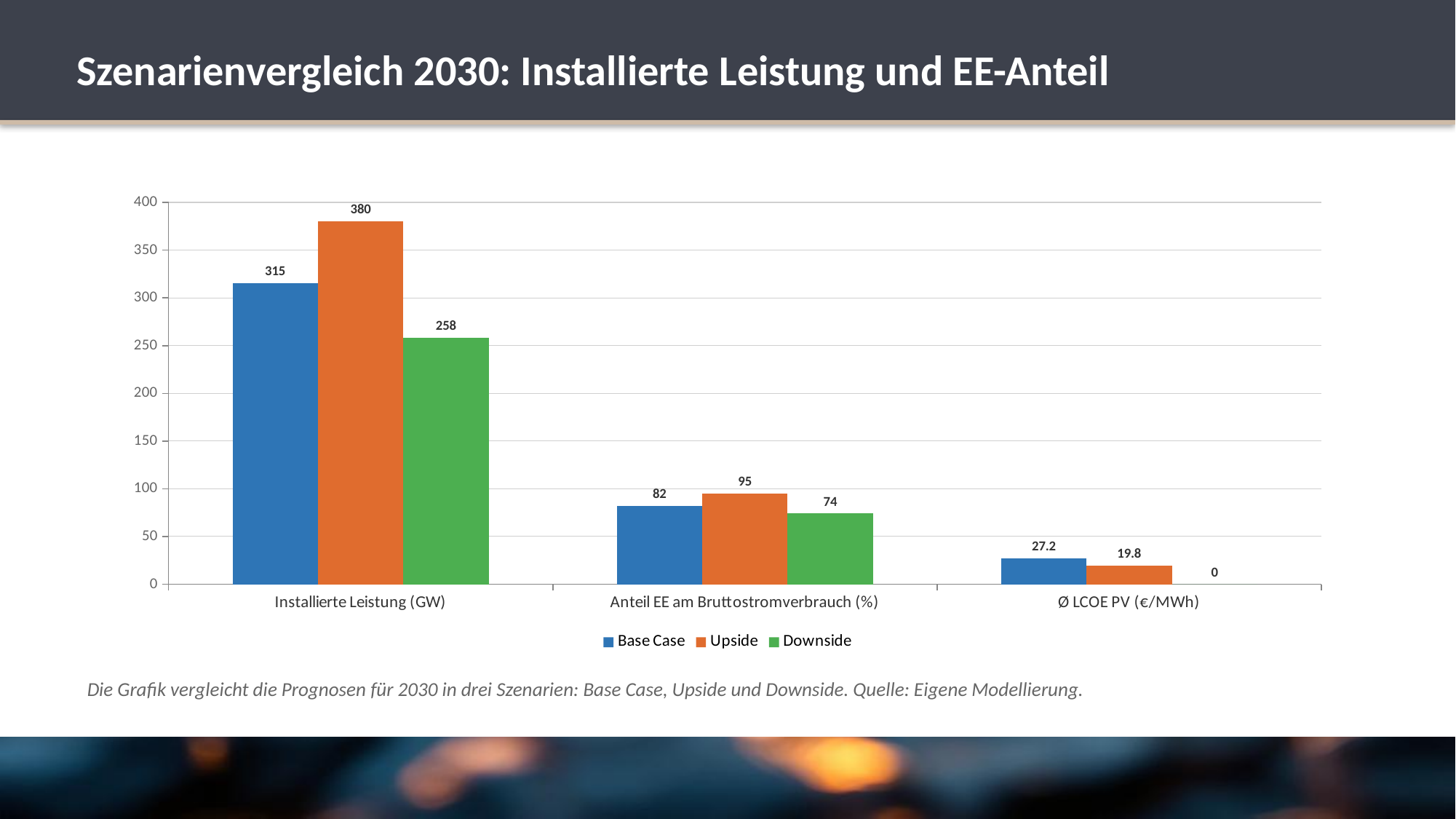
Which scenario has the highest value for Installierte Leistung (GW)? Upside How many series does the legend list? 3 How many categories are shown on the x axis? 3 What is the Base Case value for Ø LCOE PV (€/MWh)? 27.2 What is the Upside value for Installierte Leistung (GW)? 380 What kind of chart is shown on the slide? Bar chart Which is larger for Anteil EE am Bruttostromverbrauch (%): Base Case or Upside? Upside What is the difference between the Upside and Downside values for Installierte Leistung (GW)? 122 Which colour represents the Downside series in the legend? Green What is the Downside value for Anteil EE am Bruttostromverbrauch (%)? 74 What is the difference between the Base Case and Upside values for Ø LCOE PV (€/MWh)? 7.4 Which scenario has the lowest value for Ø LCOE PV (€/MWh)? Downside